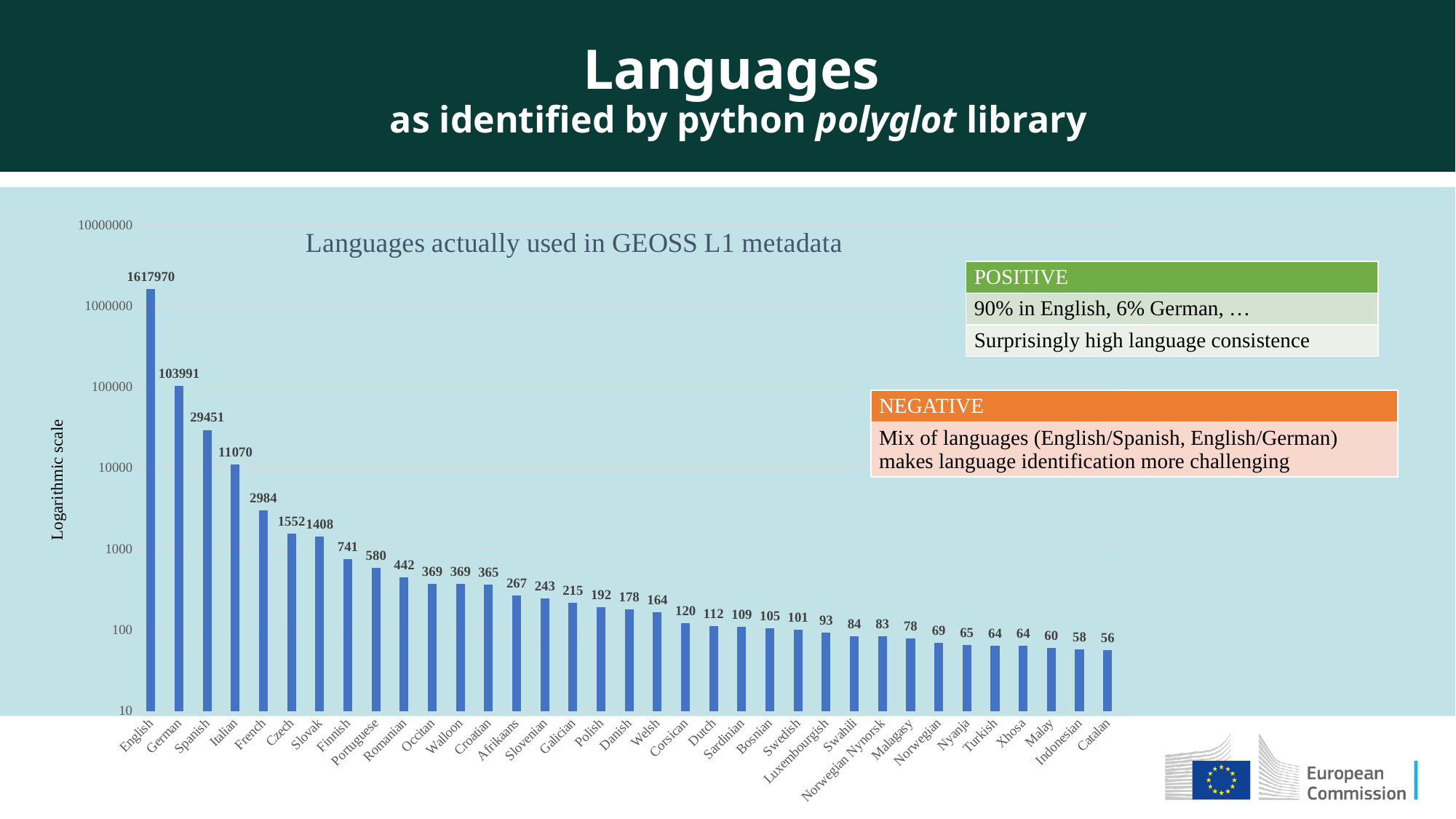
Do the values rise or fall from left to right along the x axis? Fall What kind of chart is this? Bar chart What is the difference between the values for Spanish and Italian? 18381 Which language has the lowest value? Catalan What is the value for Norwegian Nynorsk? 83 How many languages are shown on the x axis? 35 What is the title of the chart? Languages actually used in GEOSS L1 metadata What is the value for German? 103991 Which language has the highest value? English What is the value for Finnish? 741 What is the value for English? 1617970 Which has a larger value, Czech or Slovak? Czech